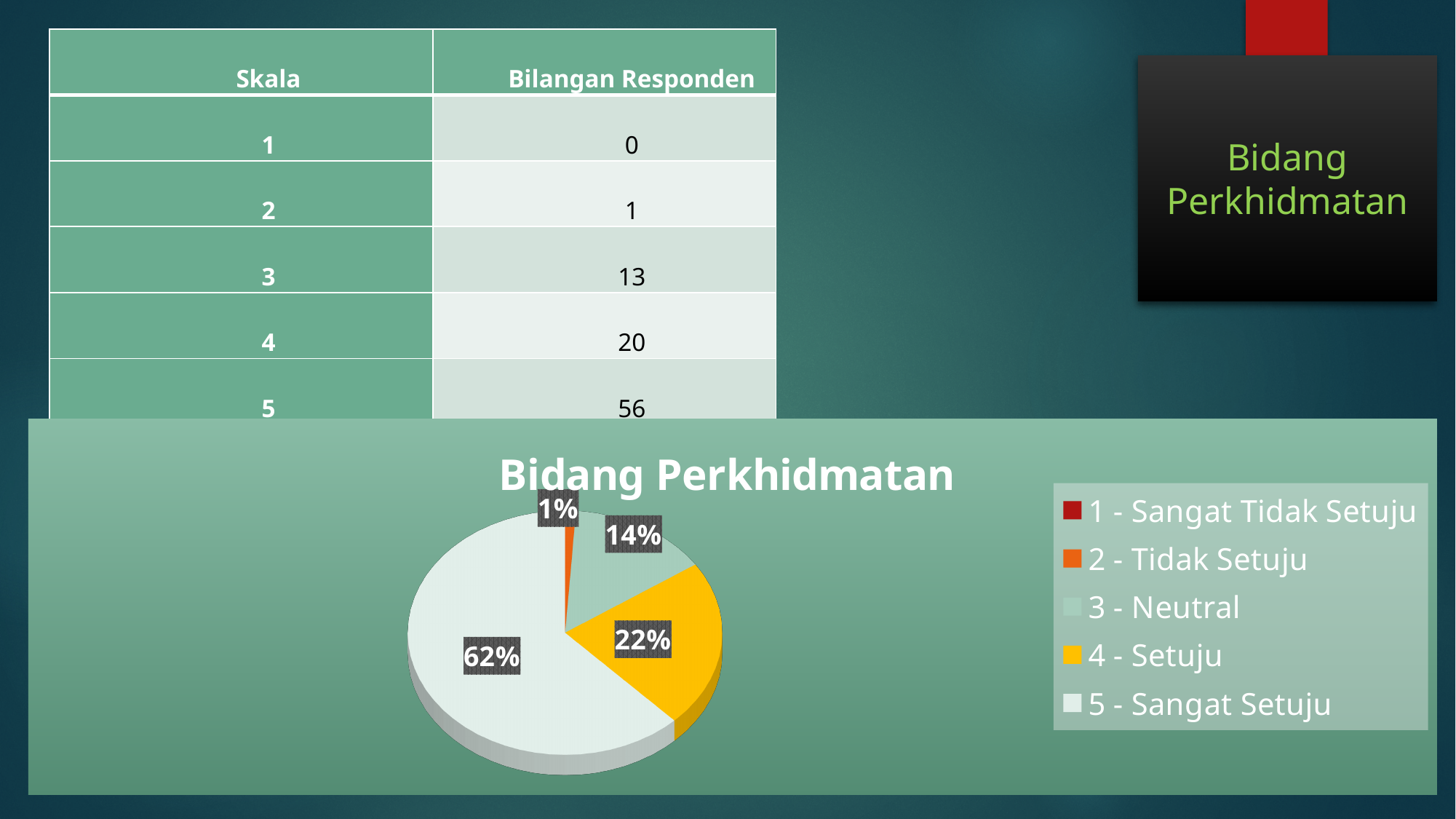
What share of the pie does the '4 - Setuju' slice represent? 22% What colour is the '4 - Setuju' slice in the pie chart? yellow What share of the pie does the '2 - Tidak Setuju' slice represent? 1% What share of the pie does the '5 - Sangat Setuju' slice represent? 62% Which of the labelled slices is the smallest? 2 - Tidak Setuju What is the title of the chart? Bidang Perkhidmatan Which slice is larger, '3 - Neutral' or '4 - Setuju'? 4 - Setuju How many entries does the chart's legend list? 5 Which legend category has the largest slice of the pie? 5 - Sangat Setuju What is the difference in percentage points between the '5 - Sangat Setuju' slice and the '4 - Setuju' slice? 40% What kind of chart is shown on the slide? pie chart